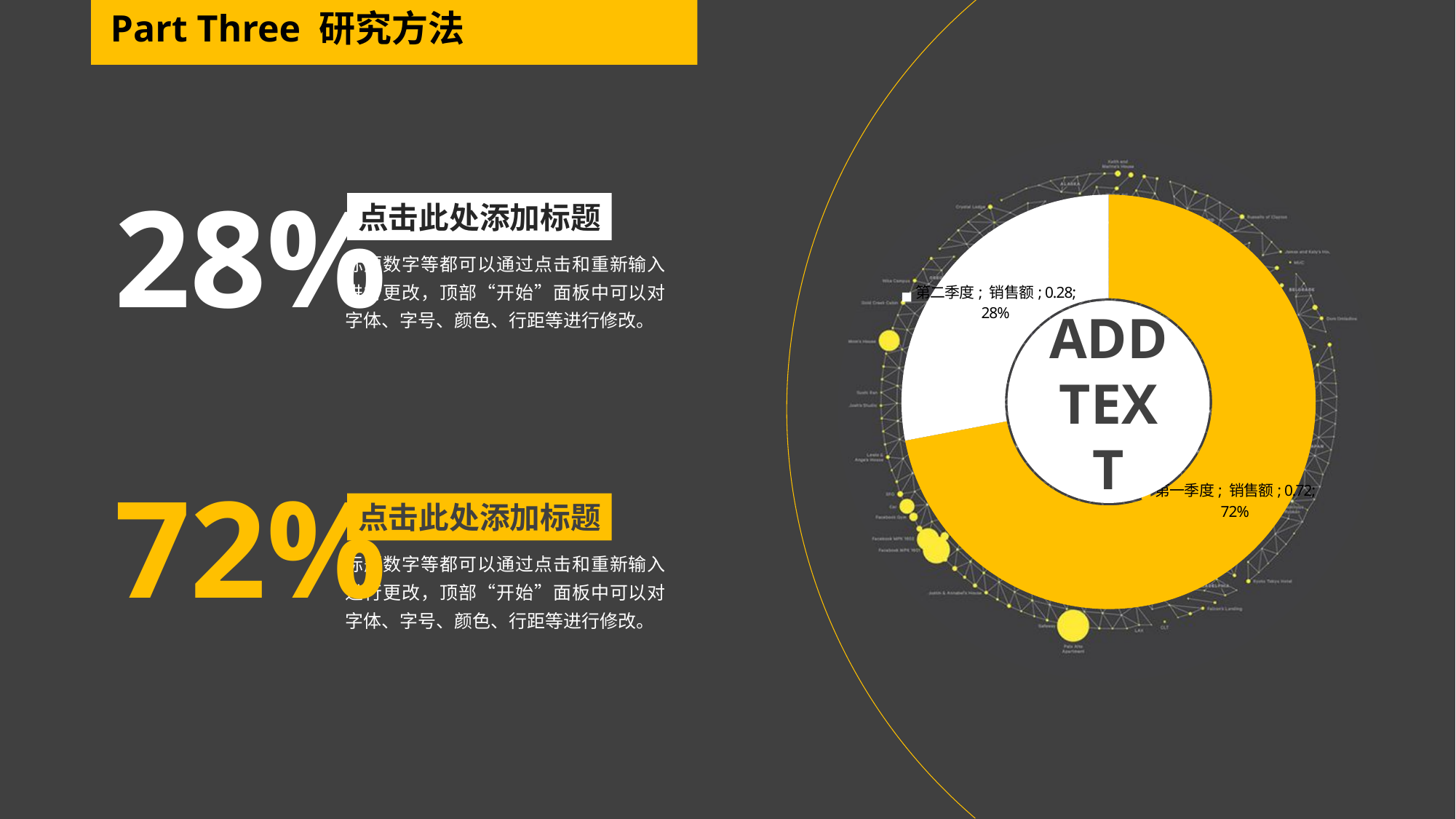
What share of the pie does 第一季度 represent? 72% What colour is the 第一季度 slice in the pie chart? yellow Which category has the smallest slice in the pie chart? 第二季度 What share of the pie does 第二季度 represent? 28% What is the difference between the values for 第一季度 and 第二季度 in the pie chart? 0.44 Which category has the largest slice in the pie chart? 第一季度 Which is larger in the pie chart, 第一季度 or 第二季度? 第一季度 What is the value shown for 第二季度 in the pie chart? 0.28 What series name appears in the pie chart's data labels? 销售额 What kind of chart is shown on the right side of the slide? doughnut chart What is the value shown for 第一季度 in the pie chart? 0.72 How many slices does the pie chart have? 2